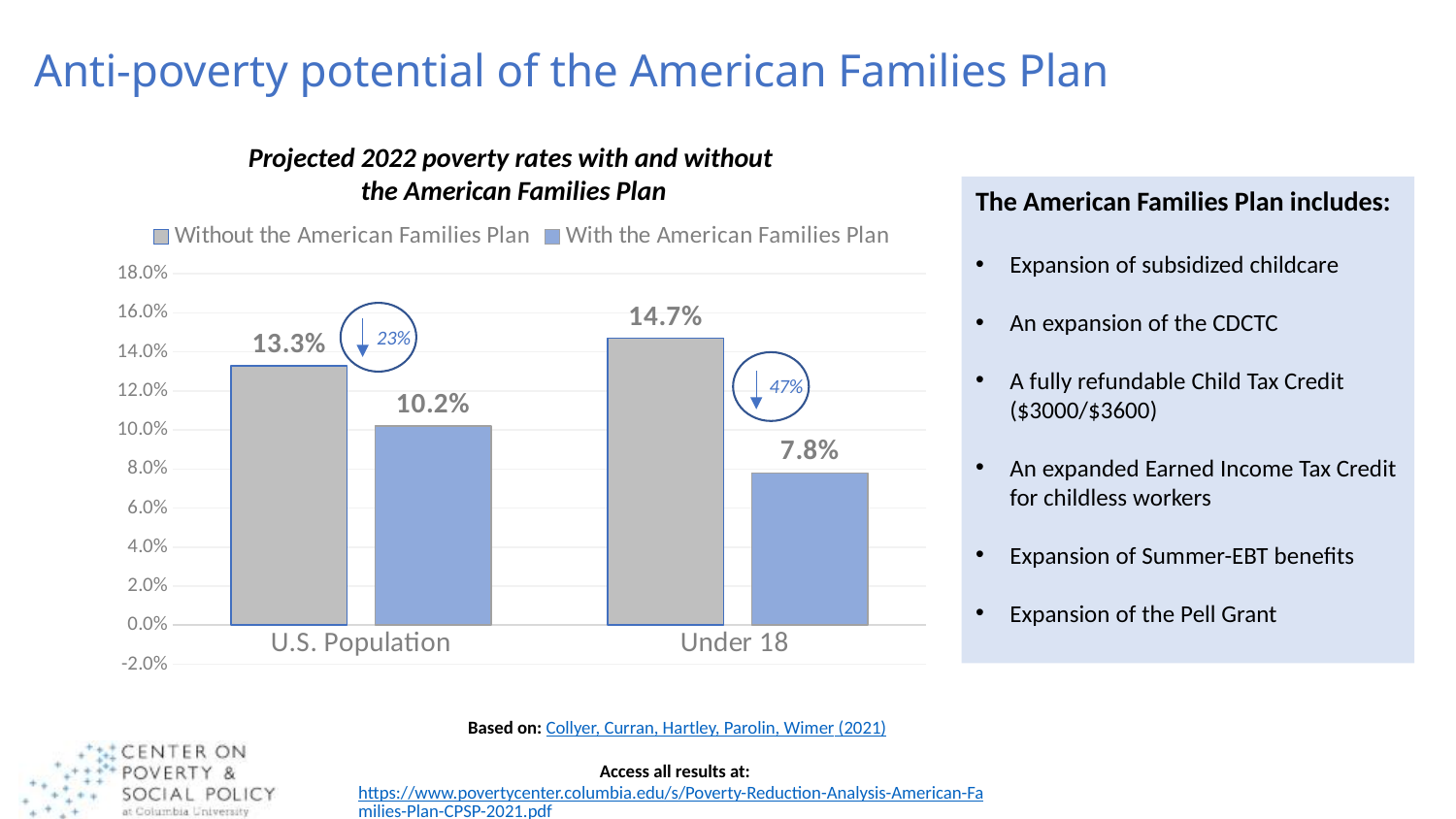
What is the projected 2022 poverty rate for the U.S. Population without the American Families Plan? 13.3% Which category has the lowest poverty rate with the American Families Plan? Under 18 What is the projected 2022 poverty rate for Under 18 with the American Families Plan? 7.8% Is the poverty rate for Under 18 without the American Families Plan higher or lower than for the U.S. Population without the plan? higher What type of chart is shown on the slide? bar chart Which category has the highest poverty rate without the American Families Plan? Under 18 What is the difference between the Under 18 poverty rate without and with the American Families Plan? 6.9% Is the value for Under 18 with the American Families Plan greater or less than 10.0%? less What is the projected 2022 poverty rate for the U.S. Population with the American Families Plan? 10.2% How many categories are shown on the x axis of the chart? 2 How many series does the chart legend list? 2 What percentage reduction is shown in the circle annotation for the Under 18 group? 47%